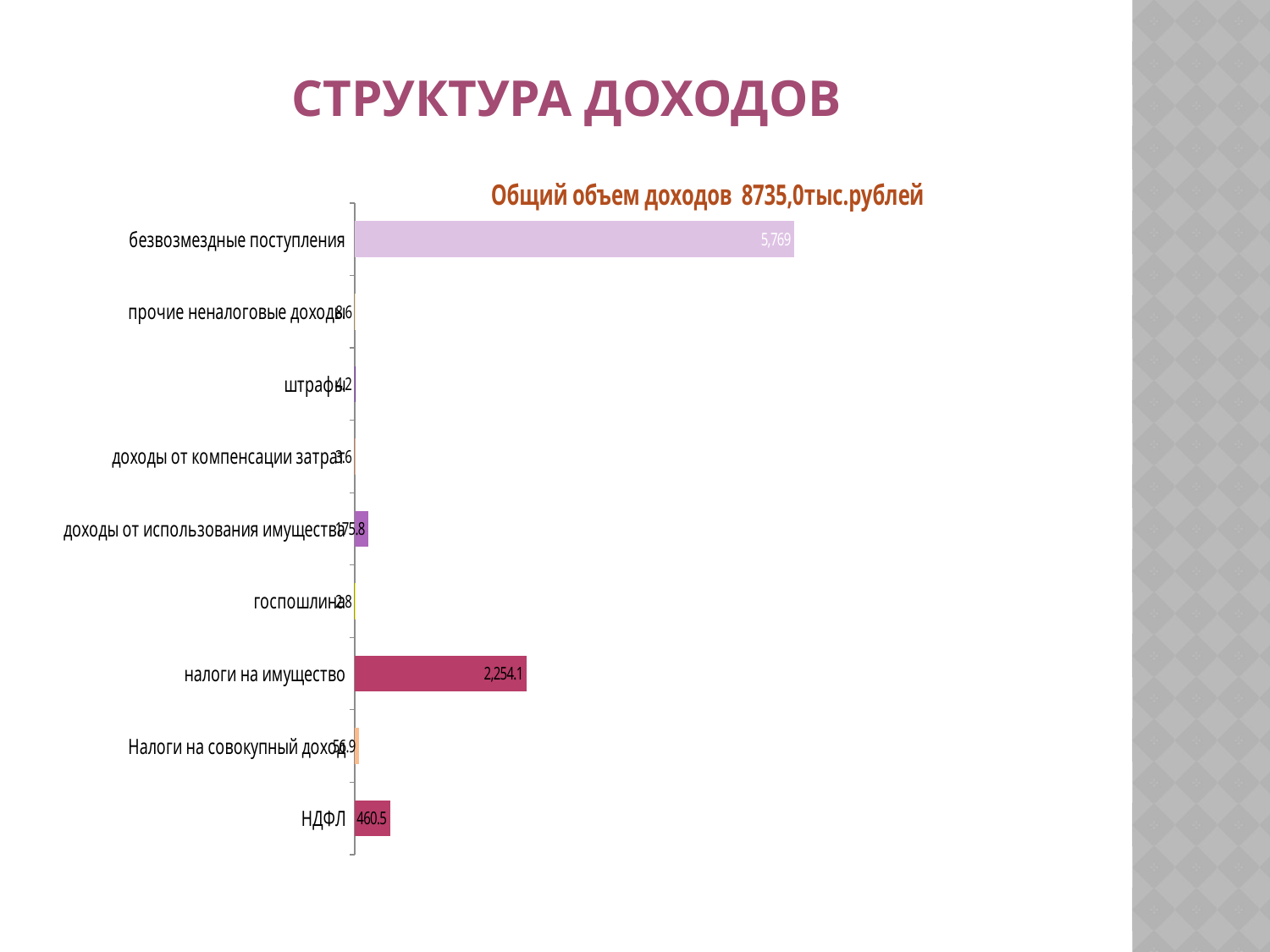
Which category has the highest value? безвозмездные поступления What is the value for безвозмездные поступления? 5,769 What is the value for налоги на имущество? 2,254.1 What is the difference between безвозмездные поступления and налоги на имущество? 3,514.9 What is the value for НДФЛ? 460.5 What kind of chart is shown on the slide? bar chart How many categories are plotted in the chart? 9 Which is larger, налоги на имущество or НДФЛ? налоги на имущество Which is larger, НДФЛ or доходы от использования имущества? НДФЛ What is the difference between налоги на имущество and НДФЛ? 1,793.6 What is the value for доходы от использования имущества? 175.8 What is the title of the chart? Общий объем доходов 8735,0тыс.рублей